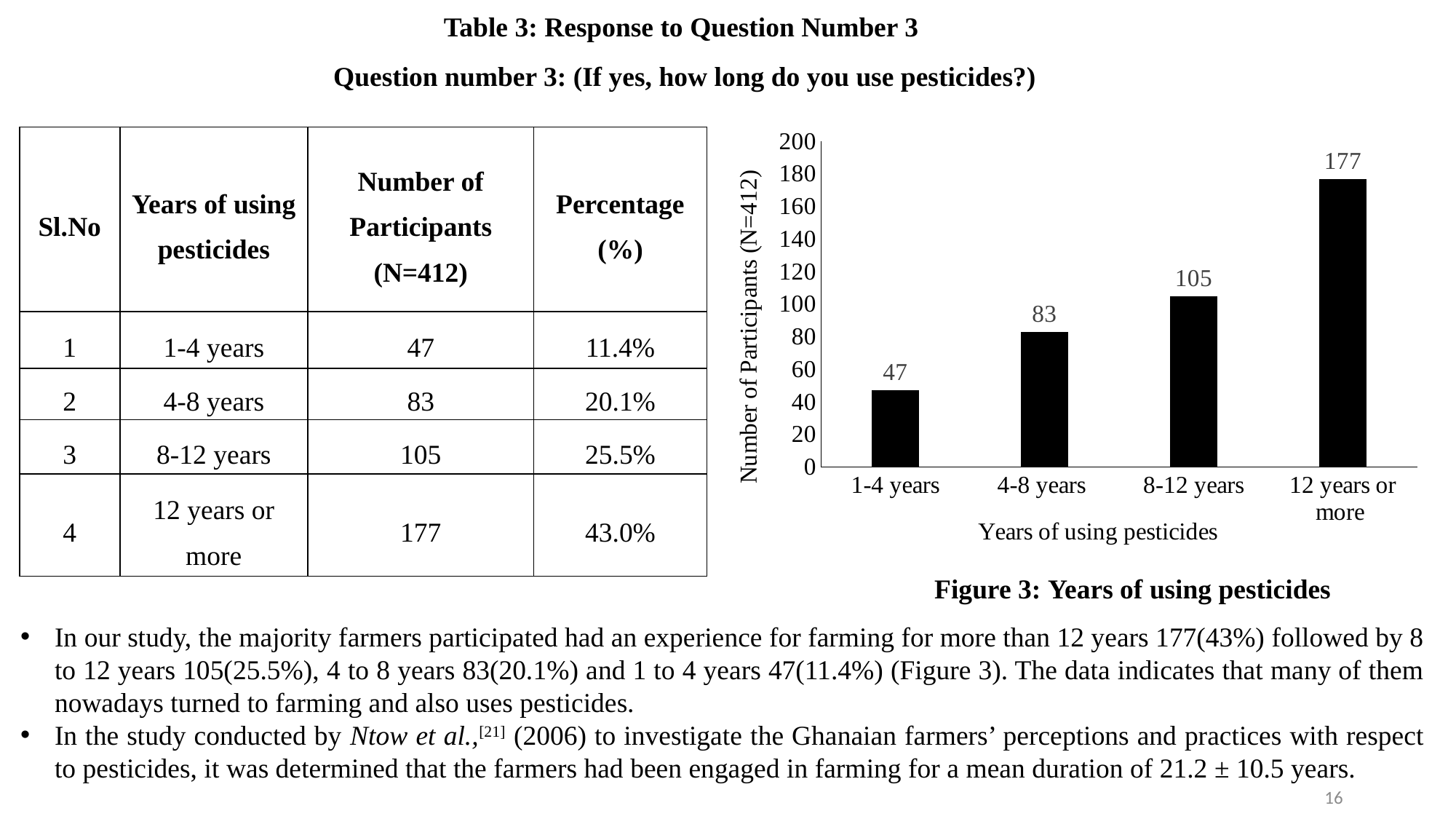
In Figure 3, what is the number of participants for 8-12 years? 105 In Figure 3, which category has the highest number of participants? 12 years or more In Figure 3, what is the difference in participants between 12 years or more and 8-12 years? 72 In Figure 3, is the value for 4-8 years greater or less than 100? less In Figure 3, which has more participants: 4-8 years or 8-12 years? 8-12 years In Figure 3, how many participants have used pesticides for 1-4 years? 47 In Figure 3, what is the difference in participants between 4-8 years and 1-4 years? 36 How many categories are shown on the x axis of Figure 3? 4 In Figure 3, which category has the lowest number of participants? 1-4 years In Figure 3, what is the number of participants for 12 years or more? 177 What kind of chart is Figure 3? bar chart In Figure 3, do the values rise or fall from left to right along the x axis? rise